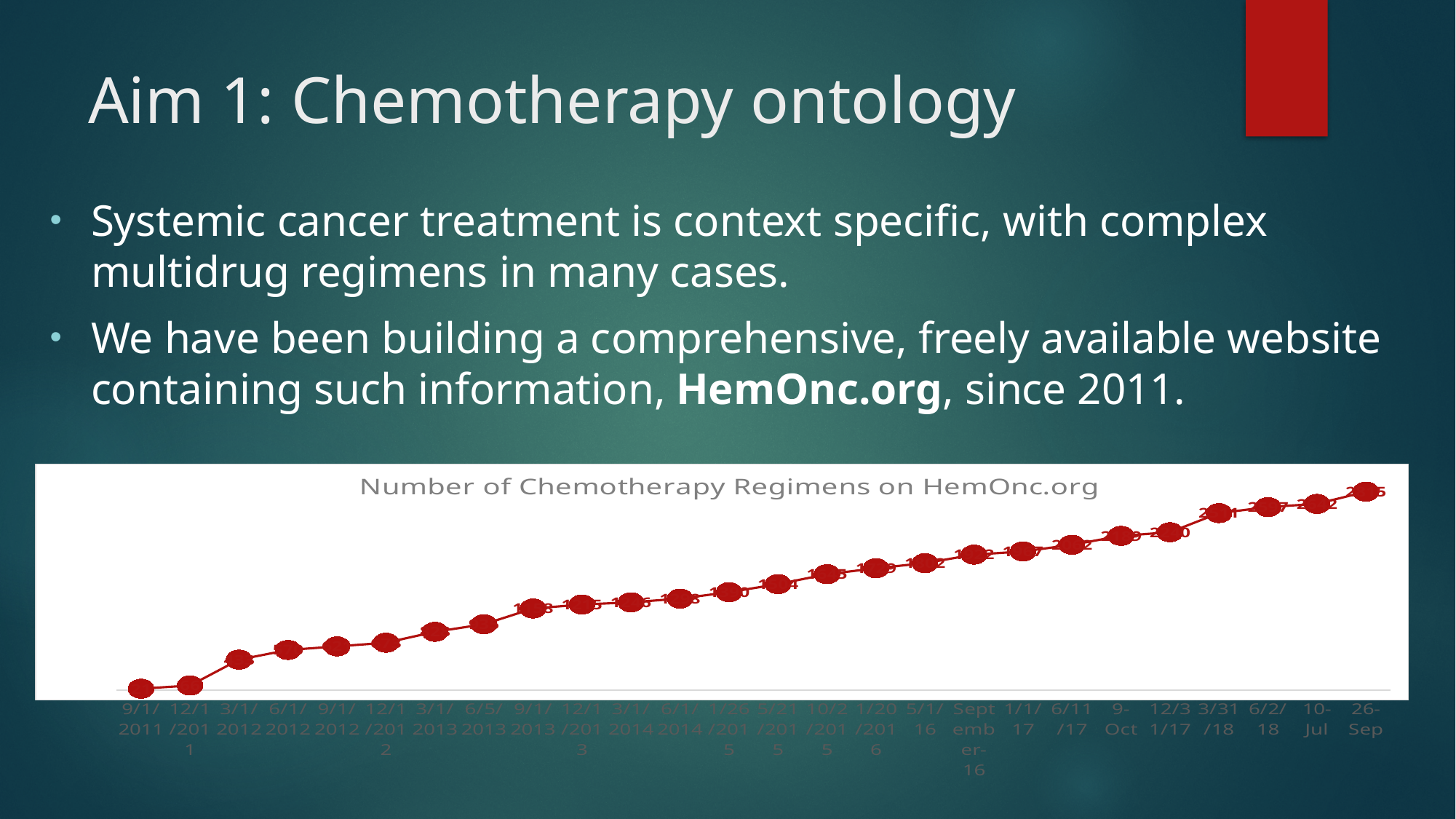
How many data points are plotted in the chart? 26 Which date has the lowest number of chemotherapy regimens in the chart? 9/1/2011 Which is larger, the value for 1/1/17 or the value for 6/5/2013? 1/1/17 Which is larger, the value for 12/1/2011 or the value for 6/2/18? 6/2/18 Which is larger, the value for 3/1/2014 or the value for 9/1/2012? 3/1/2014 What colour are the line and markers in the chart? red What kind of chart is shown on the slide? line chart Which date has the highest number of chemotherapy regimens in the chart? 26-Sep What is the first date shown on the x axis of the chart? 9/1/2011 Do the values in the chart rise or fall along the x axis from 9/1/2011 to 26-Sep? rise What is the title of the chart? Number of Chemotherapy Regimens on HemOnc.org